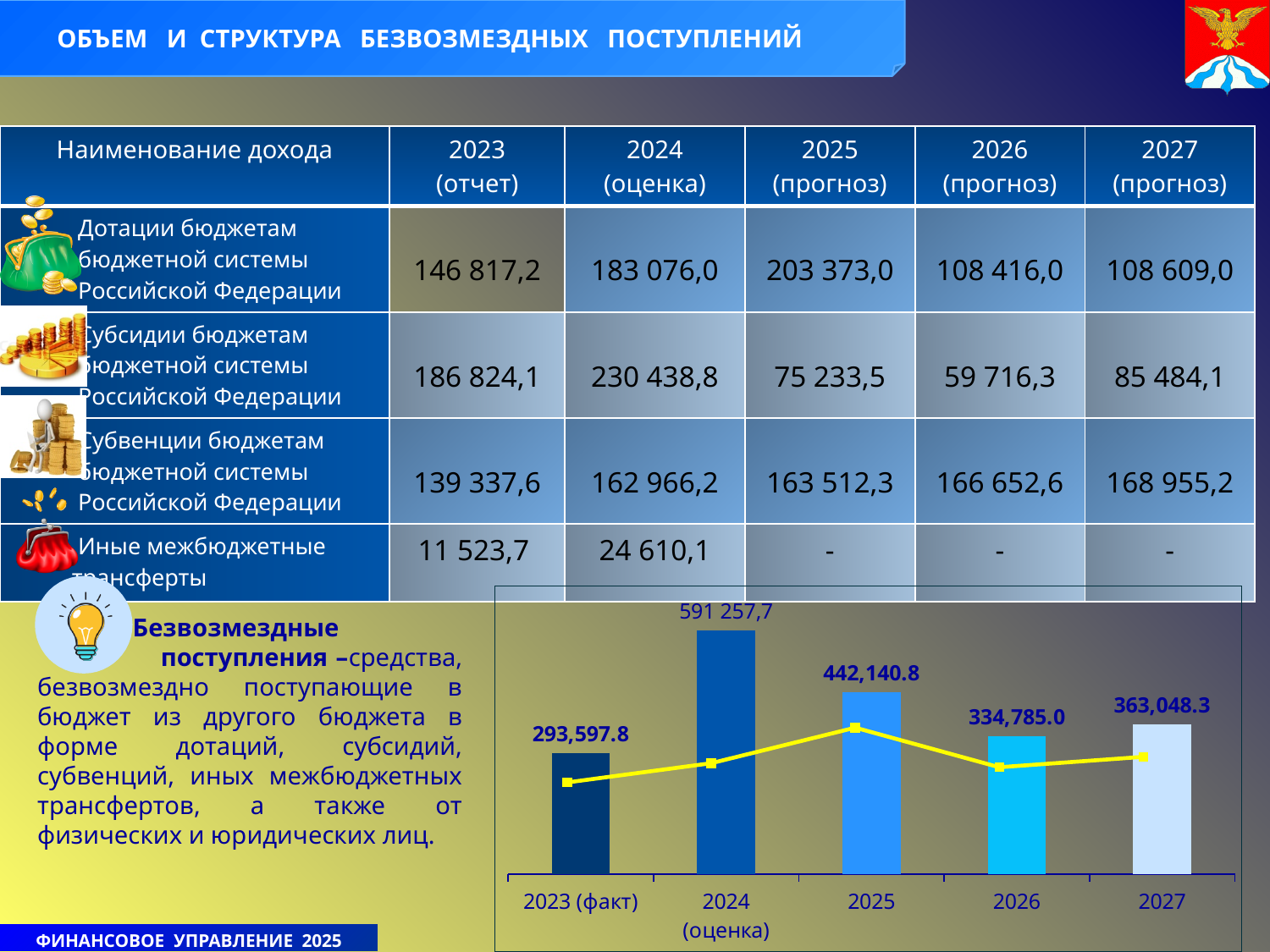
On the chart, which is larger: the value for 2025 or the value for 2027? 2025 What value is shown for 2025 on the chart? 442,140.8 What value is shown for 2027 on the chart? 363,048.3 Which year has the highest value on the chart? 2024 (оценка) Do the chart values rise or fall from 2024 to 2026? fall What value is shown for 2024 (оценка) on the chart? 591 257,7 How many years are plotted on the chart? 5 Which year has the lowest value on the chart? 2023 (факт) What kind of chart is shown at the bottom of the slide? bar chart What is the difference between the chart values for 2025 and 2026? 107,355.8 What value is shown for 2023 (факт) on the chart? 293,597.8 What value is shown for 2026 on the chart? 334,785.0